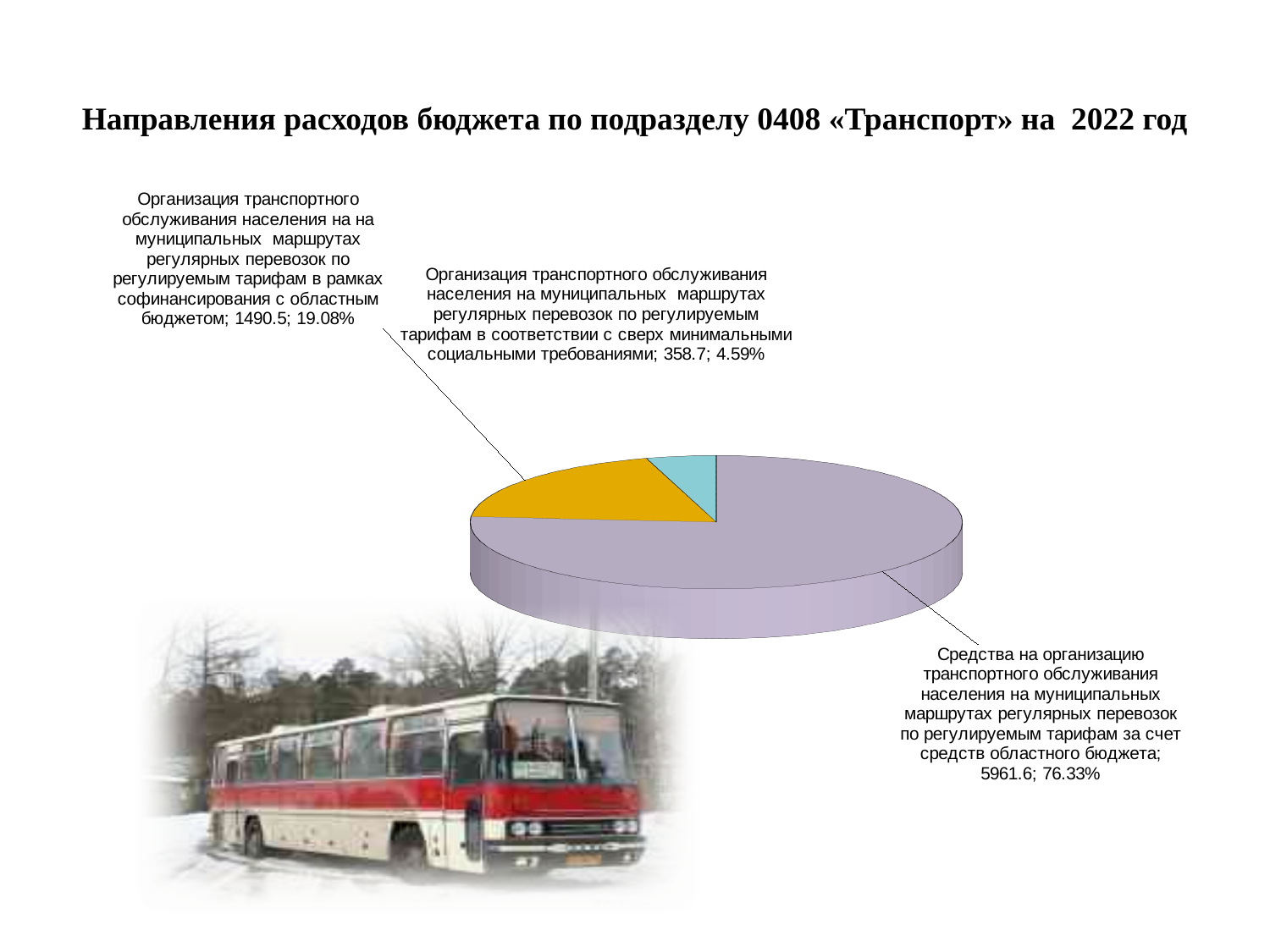
What type of chart is shown on the slide? pie chart Which slice of the pie chart is the smallest? Организация транспортного обслуживания населения на муниципальных маршрутах регулярных перевозок по регулируемым тарифам в соответствии с сверх минимальными социальными требованиями What is the value for the slice 'Средства на организацию транспортного обслуживания ... за счет средств областного бюджета'? 5961.6 What is the difference between the value for 'в рамках софинансирования с областным бюджетом' (1490.5) and the value for 'сверх минимальными социальными требованиями' (358.7)? 1131.8 What share of the pie does the slice 'за счет средств областного бюджета' represent? 76.33% Which is larger: the slice 'в рамках софинансирования с областным бюджетом' or the slice 'сверх минимальными социальными требованиями'? в рамках софинансирования с областным бюджетом What is the value for the slice 'в соответствии с сверх минимальными социальными требованиями'? 358.7 Which slice of the pie chart is the largest? Средства на организацию транспортного обслуживания населения на муниципальных маршрутах регулярных перевозок по регулируемым тарифам за счет средств областного бюджета What percentage is shown for the slice 'в соответствии с сверх минимальными социальными требованиями'? 4.59% What is the value for the slice 'в рамках софинансирования с областным бюджетом'? 1490.5 How many slices does the pie chart have? 3 What is the title of the slide containing the pie chart? Направления расходов бюджета по подразделу 0408 «Транспорт» на 2022 год